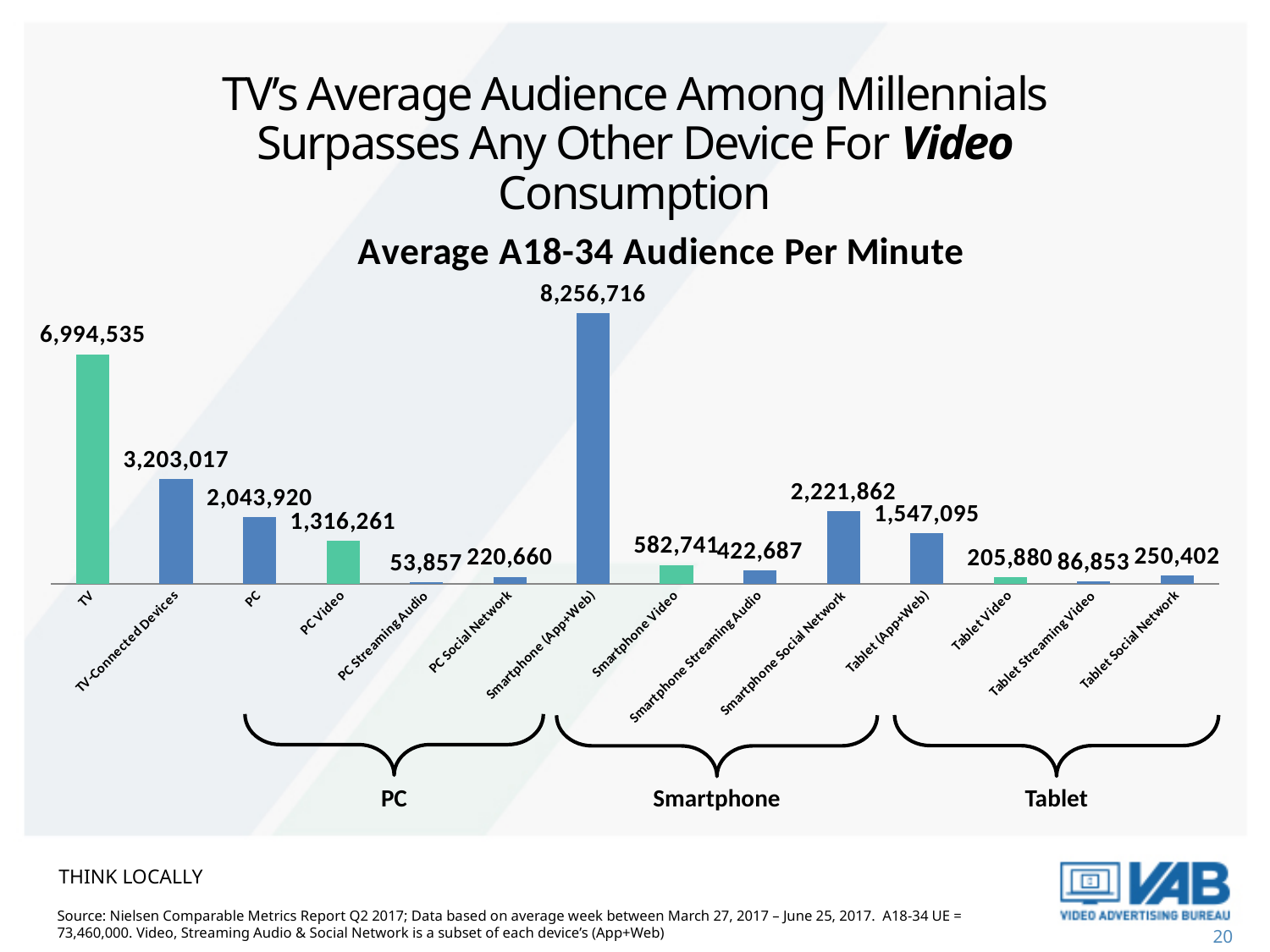
What is the difference between the values for TV and PC Video? 5,678,274 How many categories are plotted in the chart? 14 What is the difference between the values for Smartphone (App+Web) and TV? 1,262,181 What is the value shown for Smartphone (App+Web)? 8,256,716 What is the value shown for Tablet Video? 205,880 Which is larger, the value for Smartphone Video or the value for Tablet (App+Web)? Tablet (App+Web) What kind of chart is shown on the slide? Bar chart What is the value shown for PC Social Network? 220,660 Which category has the lowest Average A18-34 Audience Per Minute? PC Streaming Audio Which category has the highest Average A18-34 Audience Per Minute? Smartphone (App+Web) What is the Average A18-34 Audience Per Minute for TV? 6,994,535 Which three device groups are labelled with brackets below the chart? PC, Smartphone, Tablet